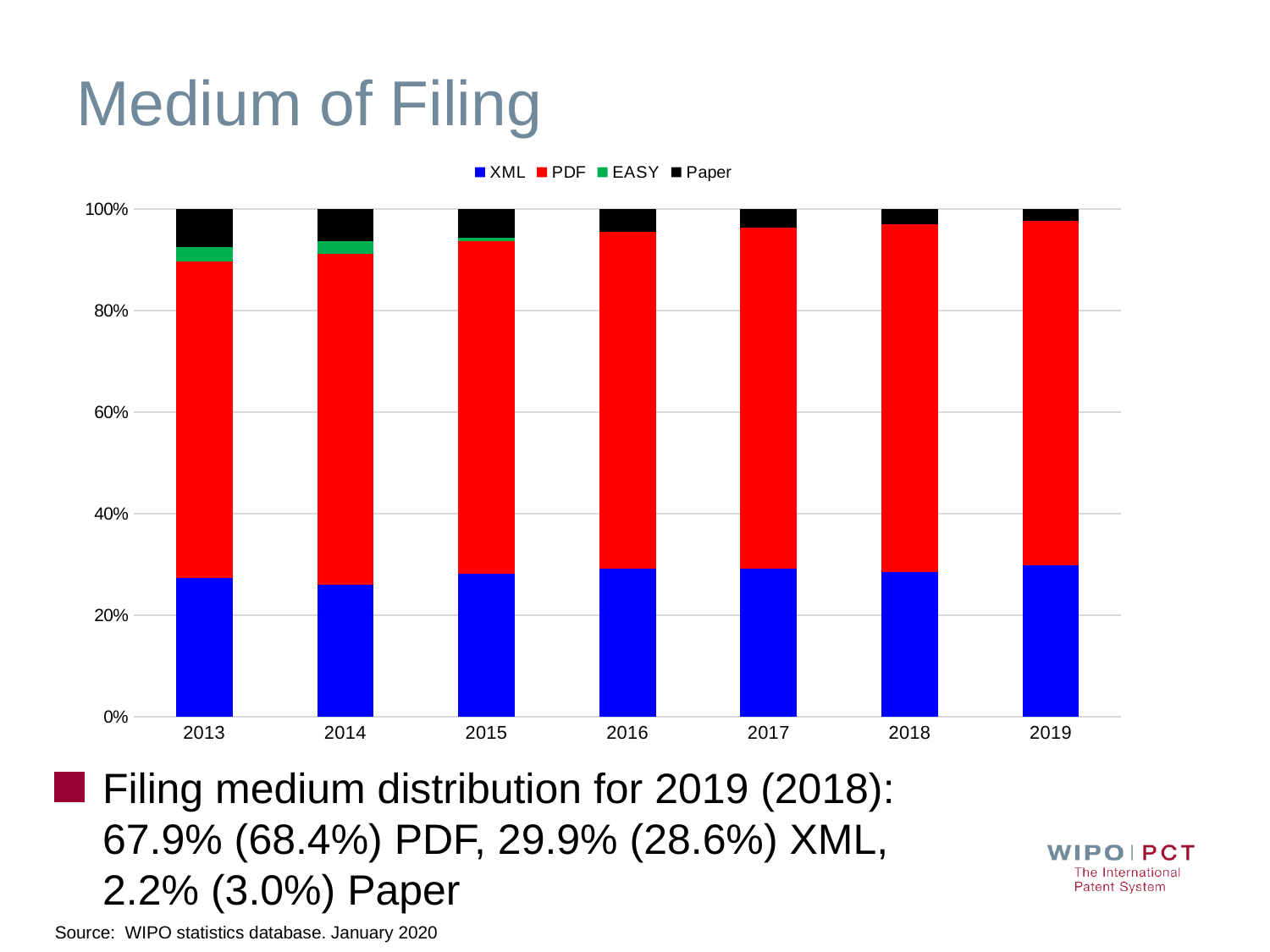
Which filing medium had the largest share in 2019? PDF How many years are shown on the x axis? 7 What colour represents PDF in the chart? Red What kind of chart is shown on the slide? Stacked bar chart According to the slide, what share of filings in 2018 were PDF? 68.4% Does the Paper share rise or fall from 2013 to 2019? fall Was the XML share larger in 2018 or in 2019? 2019 According to the slide, what share of filings in 2019 were XML? 29.9% Is the XML share for 2013 greater or less than 40%? less How many series does the legend list? 4 According to the slide, what share of filings in 2019 were Paper? 2.2% By how many percentage points did the PDF share fall from 2018 to 2019? 0.5 percentage points